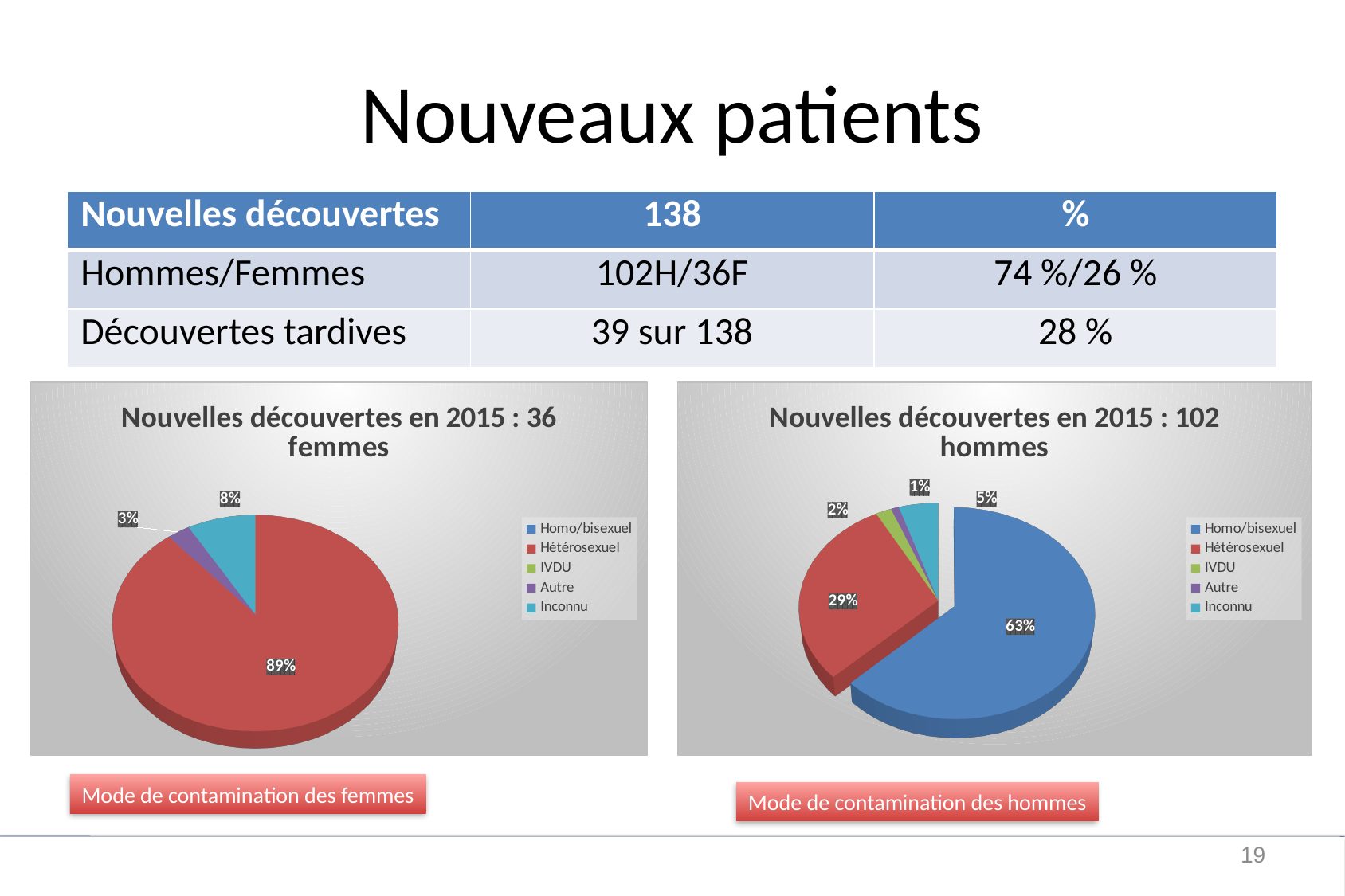
In the chart titled "Nouvelles découvertes en 2015 : 102 hommes", what share of the pie is Hétérosexuel? 29% In the chart titled "Nouvelles découvertes en 2015 : 102 hommes", which labelled category has the smallest slice? Autre What type of chart is the chart titled "Nouvelles découvertes en 2015 : 36 femmes"? Pie chart In the chart titled "Nouvelles découvertes en 2015 : 36 femmes", which is larger, Inconnu or Autre? Inconnu In the chart titled "Nouvelles découvertes en 2015 : 102 hommes", which category has the largest slice? Homo/bisexuel In the chart titled "Nouvelles découvertes en 2015 : 36 femmes", what share of the pie is Autre? 3% In the chart titled "Nouvelles découvertes en 2015 : 36 femmes", what share of the pie is Hétérosexuel? 89% In the chart titled "Nouvelles découvertes en 2015 : 102 hommes", what is the difference in percentage points between Homo/bisexuel and Hétérosexuel? 34 How many entries does the legend of the chart titled "Nouvelles découvertes en 2015 : 102 hommes" list? 5